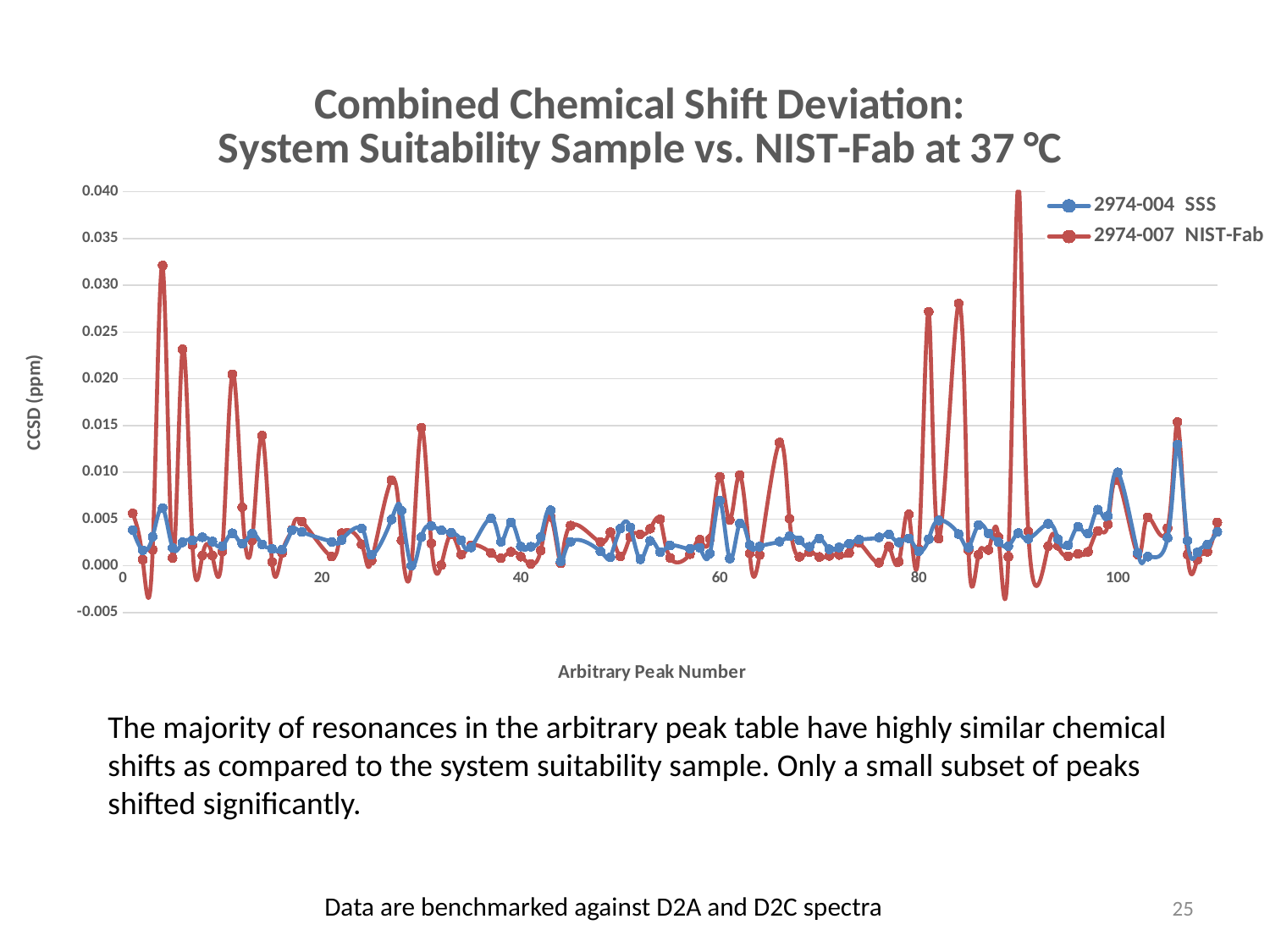
What kind of chart is shown on the slide? line chart Which series reaches the highest value anywhere on the chart? 2974-007 NIST-Fab Is the lowest value of the 2974-007 NIST-Fab series greater or less than 0.000? less What are the two series named in the legend? 2974-004 SSS and 2974-007 NIST-Fab Is the 2974-007 NIST-Fab value at its first large spike (around peak number 4) greater or less than 0.025? greater Around peak number 4, which series has the higher value? 2974-007 NIST-Fab What is the label on the vertical axis of the chart? CCSD (ppm) Is the highest value of the 2974-007 NIST-Fab series greater or less than 0.035? greater How many series does the legend list? 2